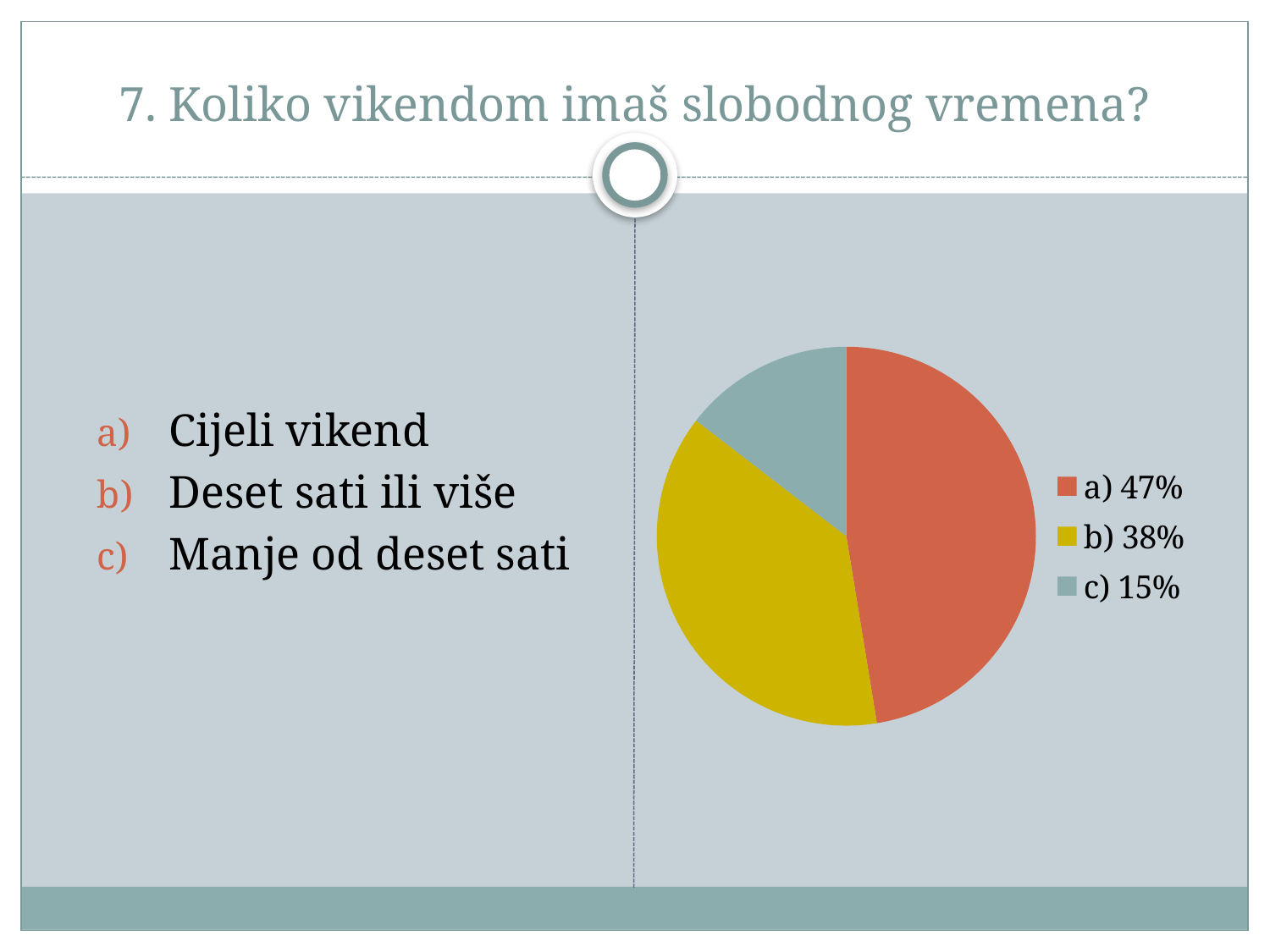
What is the difference in percentage points between option b) and option c)? 23 Which option has the largest share of the pie? a) What colour is the slice for option b) in the pie chart? yellow How many slices does the pie chart have? 3 Which is larger, the share for option b) or the share for option c)? b) What share of the pie does option c) represent? 15% Which option has the smallest share of the pie? c) How many entries does the legend list? 3 What kind of chart is shown on the slide? pie chart What share of the pie does option b) represent? 38% What share of the pie does option a) represent? 47% What is the difference in percentage points between option a) and option b)? 9